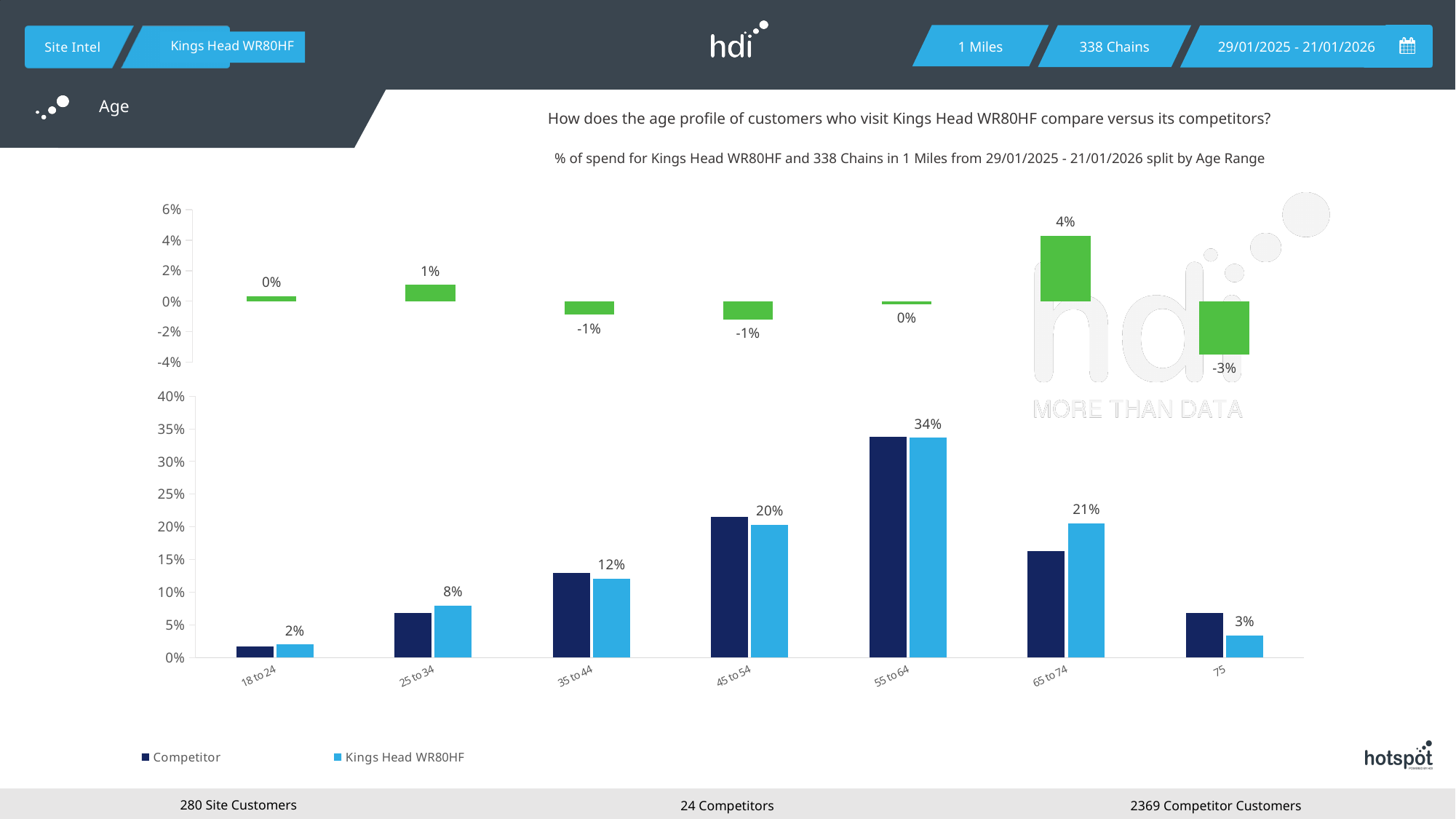
In the bottom bar chart, is the Competitor value for 65 to 74 greater or less than 15%? greater In the top chart, what is the value shown for the 75 age range? -3% How many series does the legend of the bottom bar chart list? 2 In the bottom bar chart, what is the value for Kings Head WR80HF in the 25 to 34 age range? 8% In the top chart, what is the value shown for the 65 to 74 age range? 4% In the bottom bar chart, which age range has the highest Kings Head WR80HF value? 55 to 64 In the bottom bar chart, which age range has the lowest Kings Head WR80HF value? 18 to 24 In the bottom bar chart, is the Competitor value for 35 to 44 greater or less than 15%? less How many age range categories are shown on the bottom bar chart? 7 In the bottom bar chart, which is larger for the 65 to 74 age range, the Competitor bar or the Kings Head WR80HF bar? Kings Head WR80HF In the bottom bar chart, what is the value for Kings Head WR80HF in the 55 to 64 age range? 34% In the bottom bar chart, what is the difference between the Kings Head WR80HF values for 65 to 74 and 45 to 54? 1%